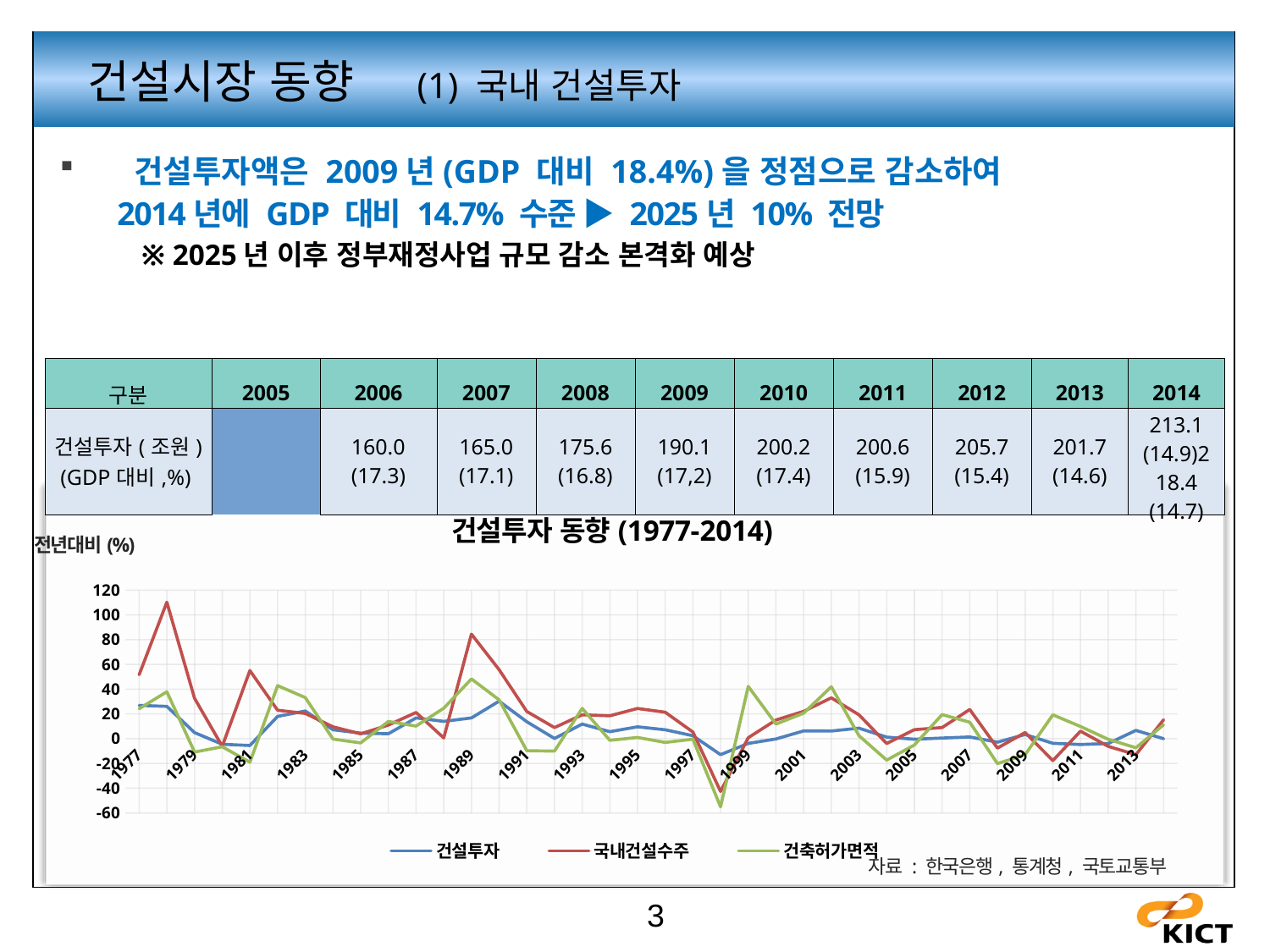
Which series reaches the lowest value anywhere on the chart? 건축허가면적 Which series is drawn in red in the chart? 국내건설수주 How many series does the legend of the chart list? 3 What is the title of the chart? 건설투자 동향 (1977-2014) In 1978, which is larger: the value for 국내건설수주 or the value for 건설투자? 국내건설수주 In 1998, which is larger: the value for 건설투자 or the value for 건축허가면적? 건설투자 What kind of chart is shown on the slide? line chart How many year labels are shown on the x axis of the chart? 19 Is the value for 건축허가면적 in 1998 greater or less than -40? less Is the value for 국내건설수주 in 1978 greater or less than 100? greater Which series reaches the highest value anywhere on the chart? 국내건설수주 Is the value for 건설투자 in 1990 greater or less than 20? greater